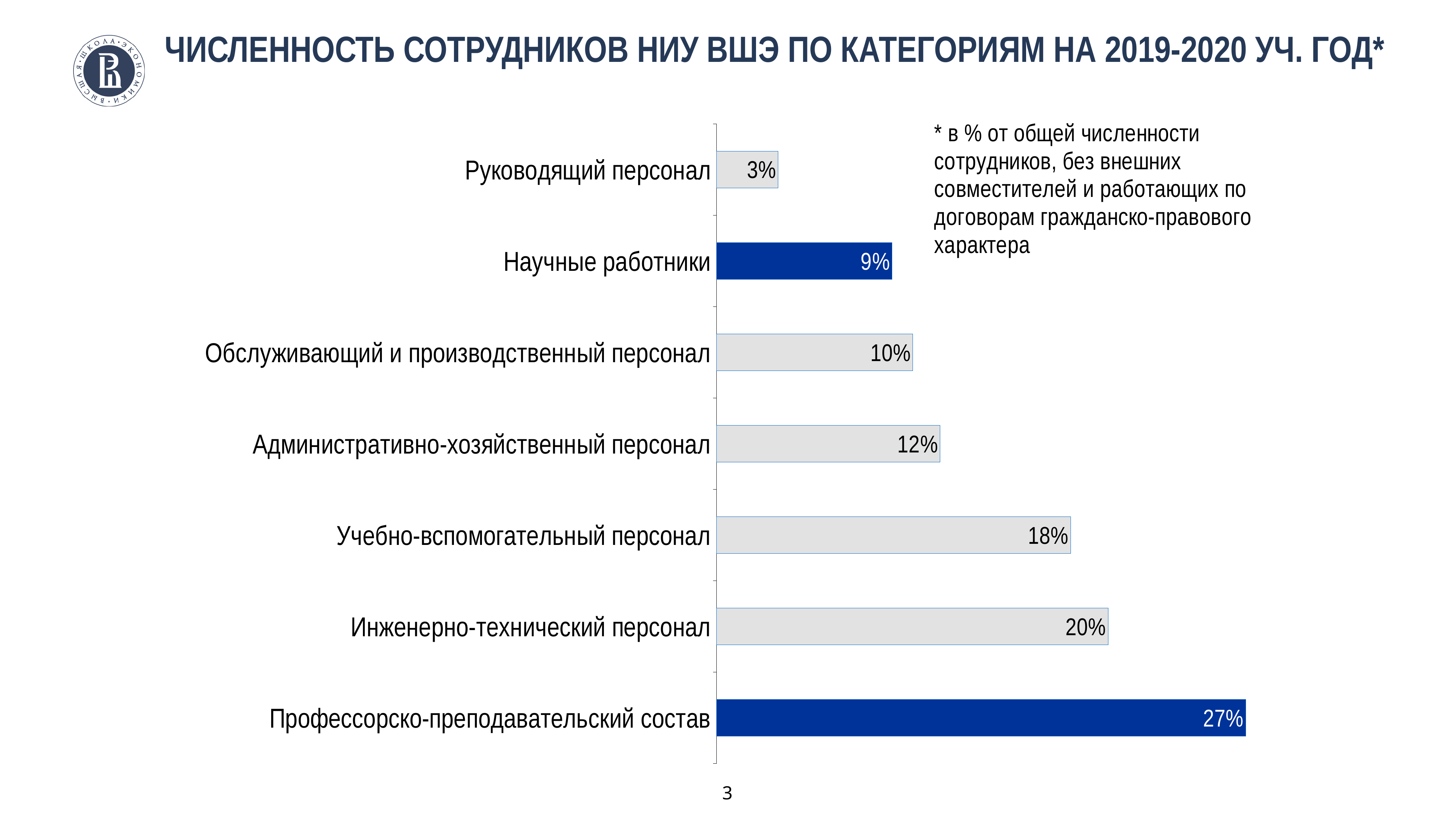
Which two categories are shown with dark blue bars? Научные работники and Профессорско-преподавательский состав Which category has the highest value? Профессорско-преподавательский состав What is the difference between Профессорско-преподавательский состав and Руководящий персонал? 24% What is the value for Учебно-вспомогательный персонал? 18% What kind of chart is shown on the slide? Bar chart How many categories are shown in the chart? 7 Which category has the lowest value? Руководящий персонал What is the value for Руководящий персонал? 3% Which is larger: Обслуживающий и производственный персонал or Научные работники? Обслуживающий и производственный персонал What is the value for Научные работники? 9% What is the value for Профессорско-преподавательский состав? 27% What is the difference between Инженерно-технический персонал and Административно-хозяйственный персонал? 8%